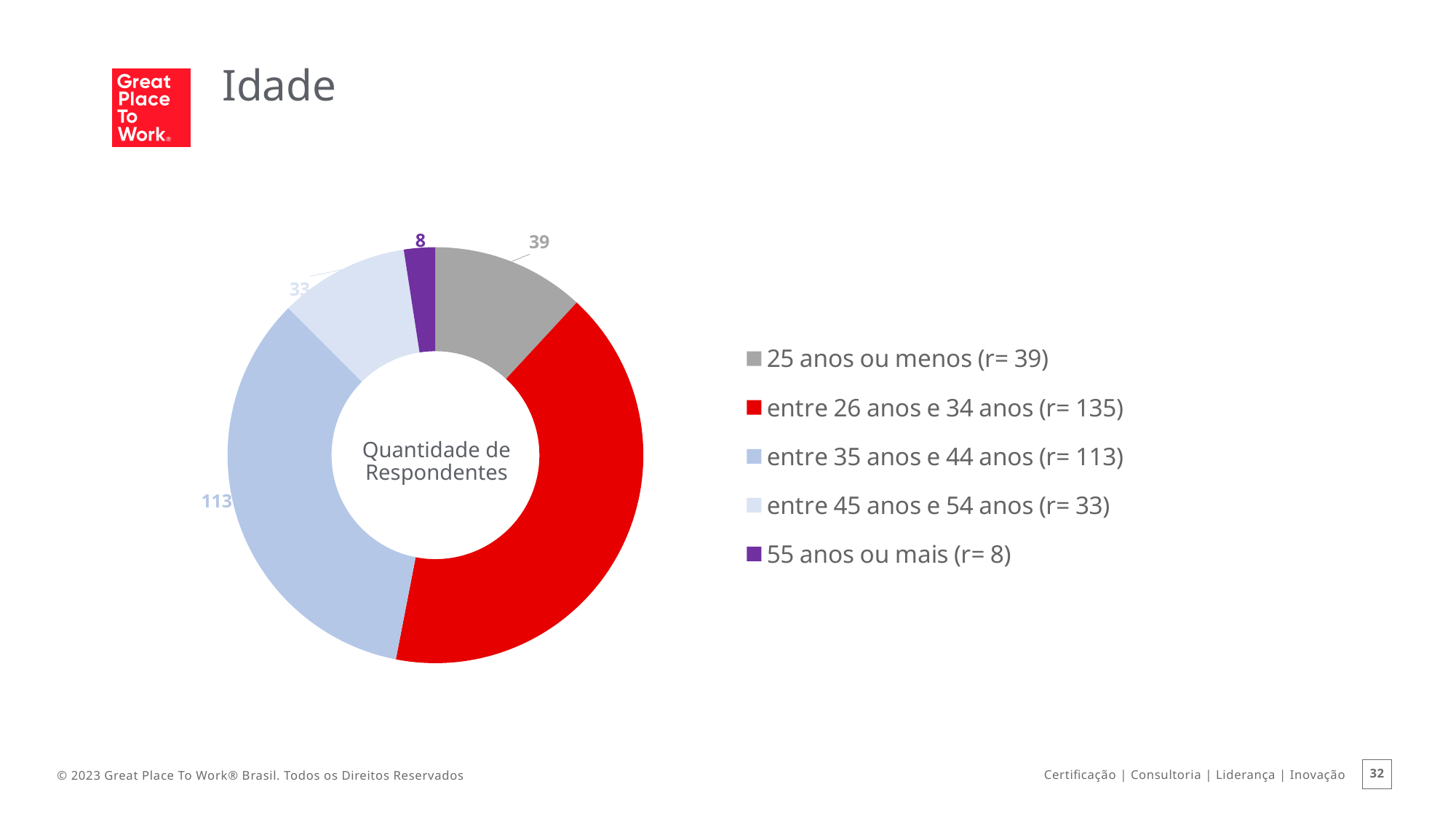
Which age category has the most respondents? entre 26 anos e 34 anos What kind of chart is shown on the slide? Pie chart (donut) Which age category has the fewest respondents? 55 anos ou mais What is the difference in respondents between 'entre 26 anos e 34 anos' and 'entre 35 anos e 44 anos'? 22 What text appears in the centre of the donut chart? Quantidade de Respondentes What is the total number of respondents across all age categories? 328 How many respondents are in the 'entre 26 anos e 34 anos' category? 135 How many age categories does the chart show? 5 What is the title of the slide? Idade How many respondents are in the '25 anos ou menos' category? 39 Which has more respondents: '25 anos ou menos' or 'entre 45 anos e 54 anos'? 25 anos ou menos How many respondents are in the 'entre 45 anos e 54 anos' category? 33